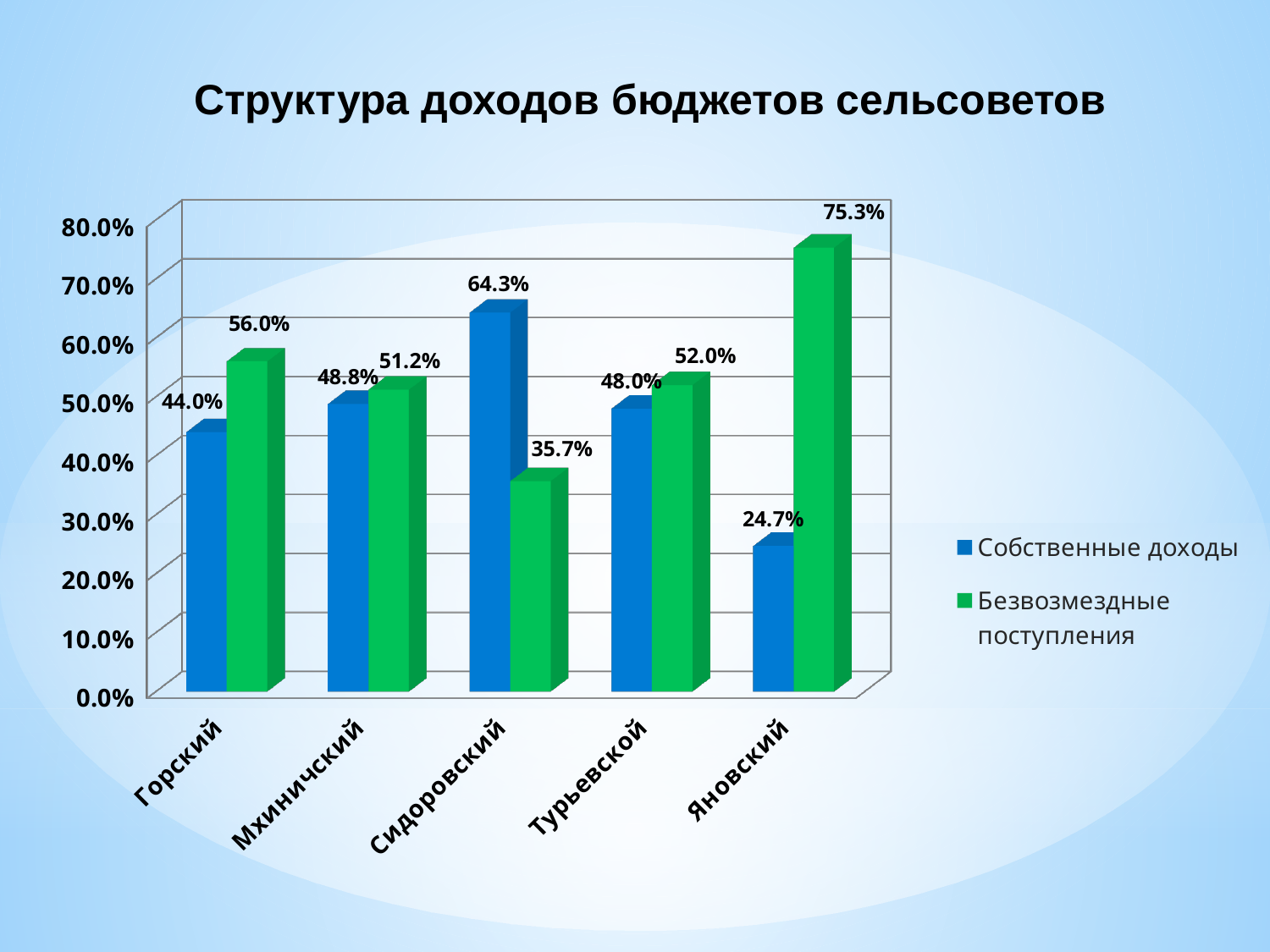
What kind of chart is shown on the slide? Bar chart Which category has the highest value of Собственные доходы? Сидоровский How many categories are shown on the x axis? 5 What is the value of Собственные доходы for Горский? 44.0% What is the difference between Безвозмездные поступления and Собственные доходы for Горский? 12.0% What is the value of Безвозмездные поступления for Сидоровский? 35.7% Which category has the lowest value of Собственные доходы? Яновский What is the value of Безвозмездные поступления for Яновский? 75.3% Which is larger for Турьевской: Собственные доходы or Безвозмездные поступления? Безвозмездные поступления What is the title of the chart? Структура доходов бюджетов сельсоветов How many series does the legend list? 2 Which category has the lowest value of Безвозмездные поступления? Сидоровский